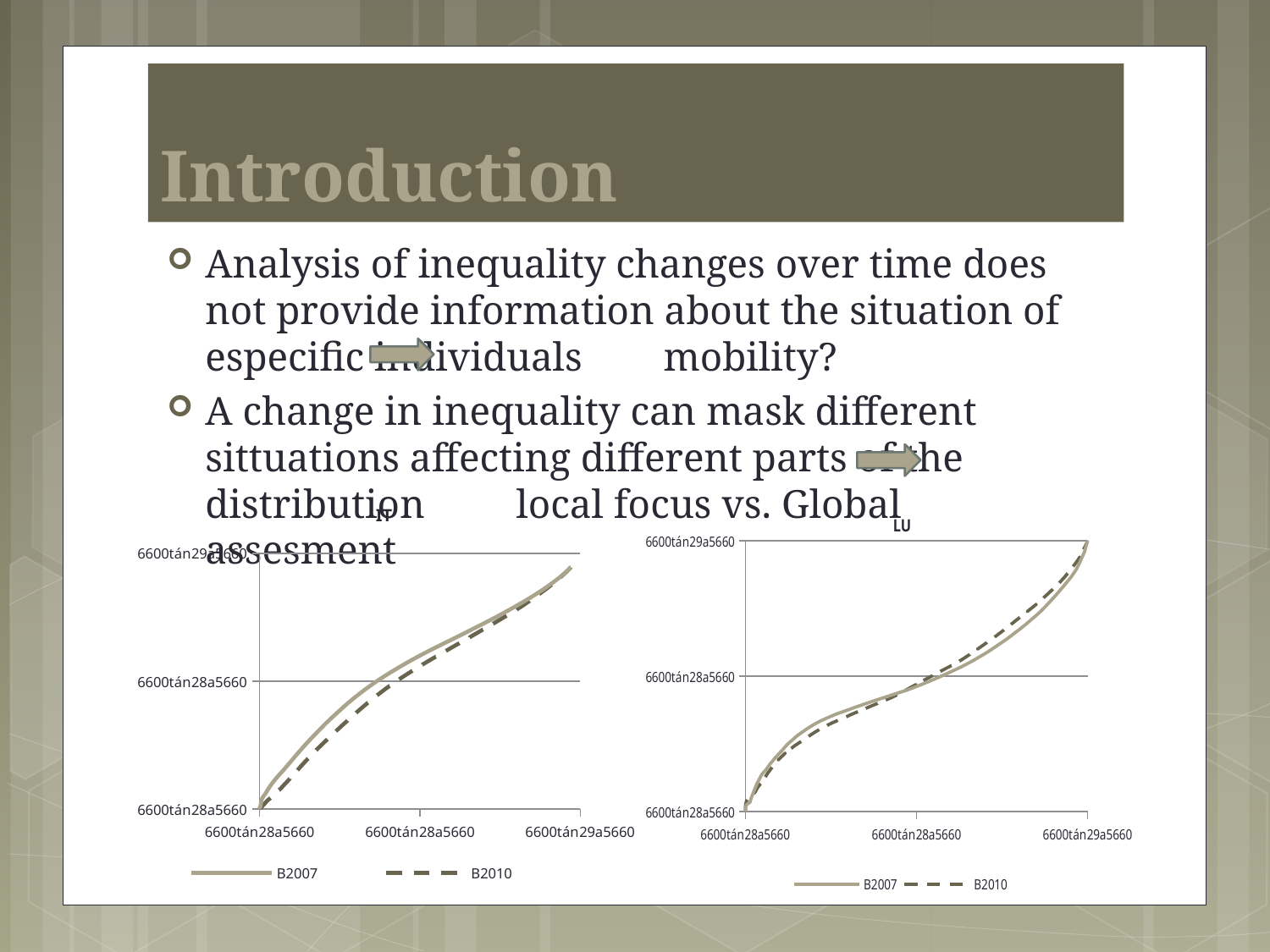
In the chart titled "LU", do the values rise or fall along the x axis? rise What kind of chart is the chart titled "LU" on the right of the slide? line chart In the left chart, do the values rise or fall along the x axis? rise How many charts are shown on the slide? 2 How many series does the legend of the chart titled "LU" list? 2 What kind of chart is the chart on the left of the slide? line chart In the left chart, which series is drawn with a dashed line? B2010 What are the two series named in the legend of the chart titled "LU"? B2007 and B2010 How many series does the legend of the left chart list? 2